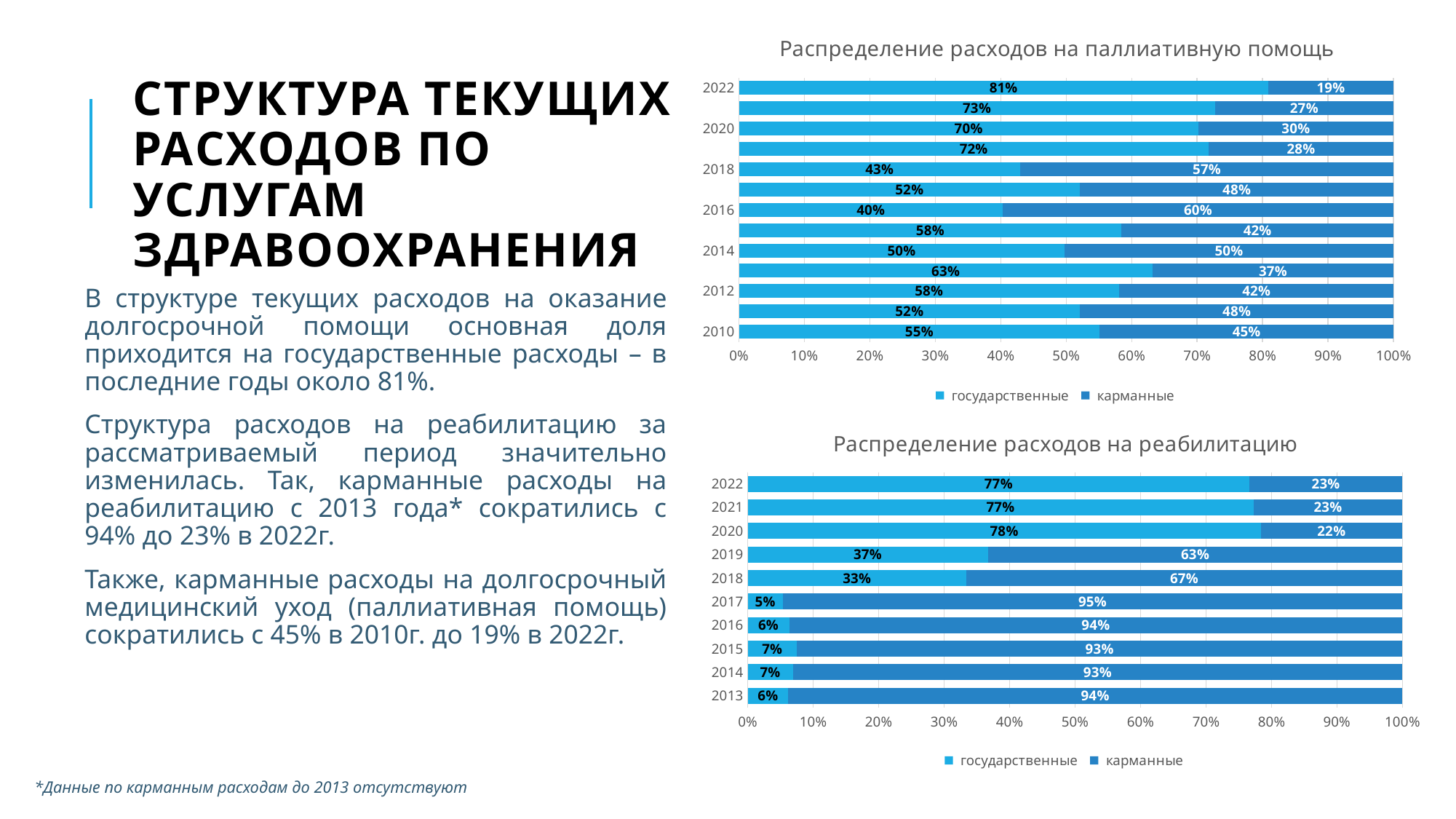
In the chart 'Распределение расходов на паллиативную помощь', what is the difference between the 'карманные' values for 2018 and 2022? 38% In the chart 'Распределение расходов на паллиативную помощь', what is the value for 'государственные' in 2022? 81% In the chart 'Распределение расходов на реабилитацию', is the 'государственные' value for 2020 larger or smaller than the 'государственные' value for 2018? larger In the chart 'Распределение расходов на реабилитацию', how many years are shown? 10 In the chart 'Распределение расходов на реабилитацию', which year has the highest value for 'карманные'? 2017 In the chart 'Распределение расходов на реабилитацию', what is the value for 'государственные' in 2019? 37% In the chart 'Распределение расходов на паллиативную помощь', which year has the highest value for 'государственные'? 2022 In the chart 'Распределение расходов на паллиативную помощь', what is the value for 'карманные' in 2016? 60% In the chart 'Распределение расходов на паллиативную помощь', what is the value for 'карманные' in 2010? 45% What kind of chart is 'Распределение расходов на реабилитацию'? stacked bar chart In the chart 'Распределение расходов на реабилитацию', what is the value for 'карманные' in 2013? 94% In the chart 'Распределение расходов на паллиативную помощь', how many series does the legend list? 2